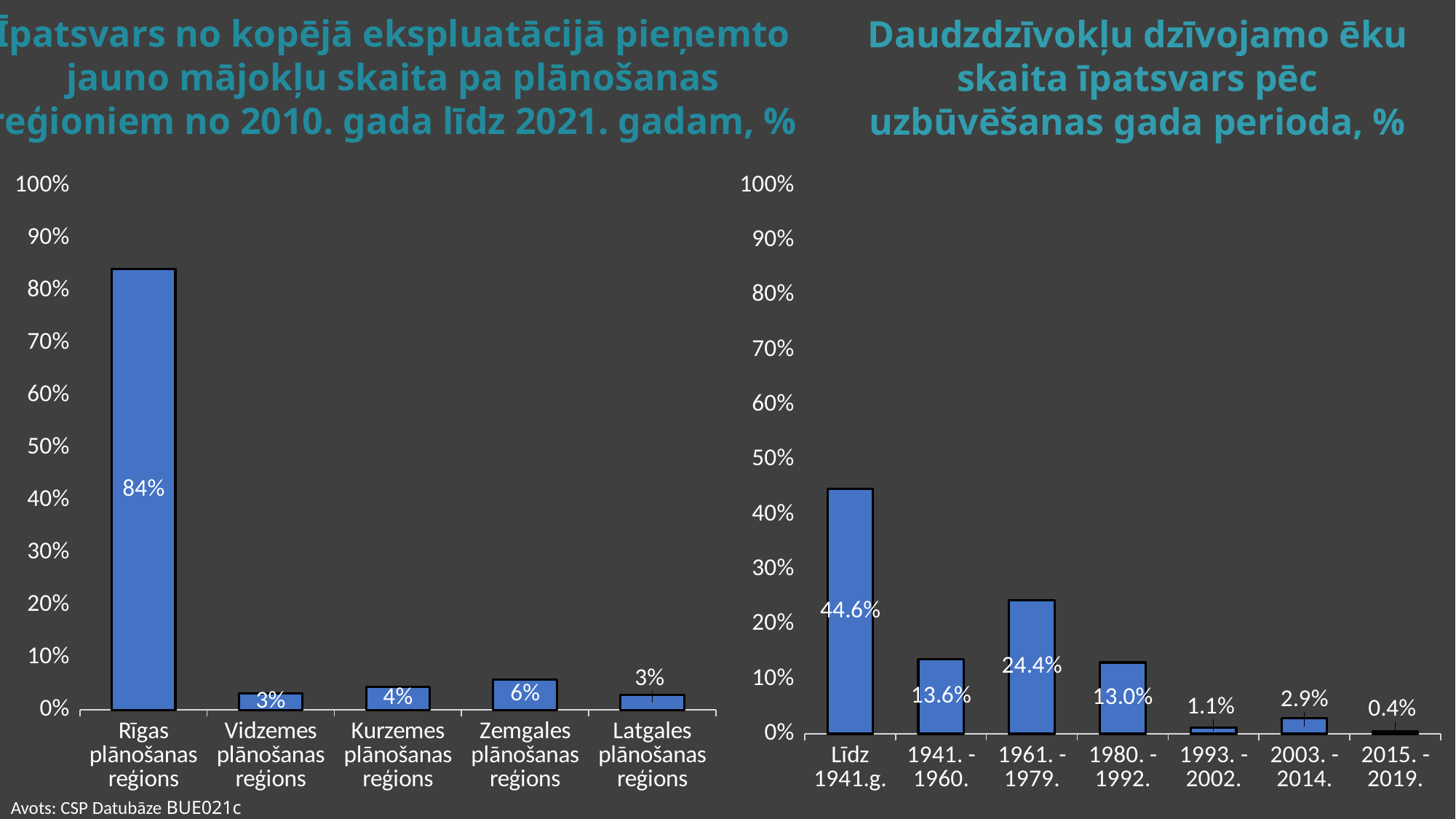
In the right chart, what is the value for the period 1961. - 1979.? 24.4% In the left chart, how many regions are shown? 5 In the right chart, which period has the lowest value? 2015. - 2019. In the left chart, is the value for Rīgas plānošanas reģions greater or less than 80%? greater What kind of chart is the right chart? bar chart In the left chart, which region has the highest value? Rīgas plānošanas reģions In the right chart, what is the value for the period 2003. - 2014.? 2.9% In the right chart, which is larger: the value for 1941. - 1960. or the value for 1980. - 1992.? 1941. - 1960. In the left chart, what is the difference between Rīgas plānošanas reģions and Kurzemes plānošanas reģions? 80% In the left chart, what is the value for Zemgales plānošanas reģions? 6% In the right chart, which period has the highest value? Līdz 1941.g. In the left chart, what is the value for Rīgas plānošanas reģions? 84%